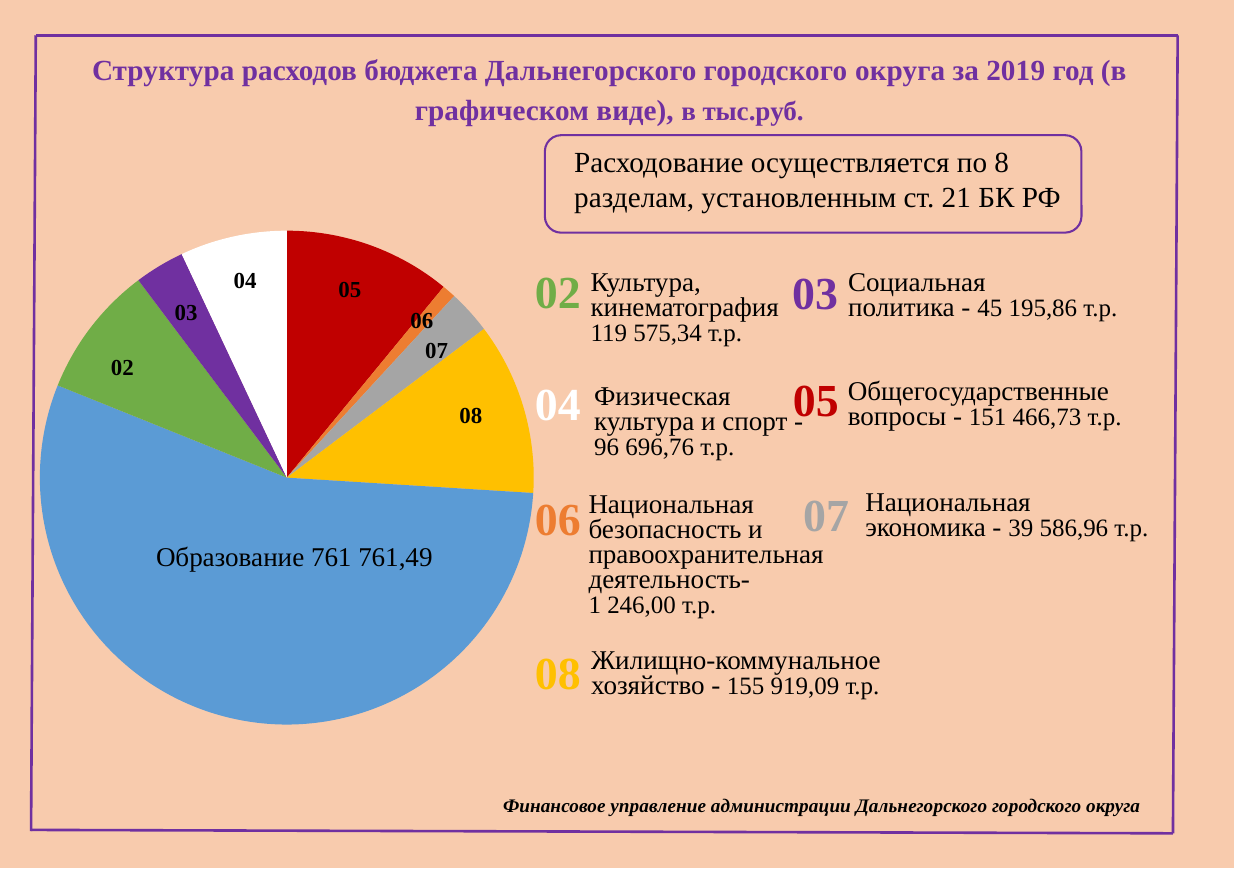
What is the value for section 06 Национальная безопасность и правоохранительная деятельность? 1 246,00 т.р. What is the value for section 05 Общегосударственные вопросы? 151 466,73 т.р. What colour is the slice for Образование in the pie chart? blue Which section has the largest share of the pie chart? Образование Which is larger: section 08 Жилищно-коммунальное хозяйство or section 05 Общегосударственные вопросы? 08 Жилищно-коммунальное хозяйство What type of chart is shown on the slide? pie chart What is the difference between section 02 Культура, кинематография and section 04 Физическая культура и спорт? 22 878,58 т.р. How many slices does the pie chart have? 8 What is the value for Образование in the pie chart? 761 761,49 Which section has the smallest share of the pie chart? 06 Национальная безопасность и правоохранительная деятельность What is the difference between section 03 Социальная политика and section 07 Национальная экономика? 5 608,90 т.р. What is the value for section 08 Жилищно-коммунальное хозяйство? 155 919,09 т.р.